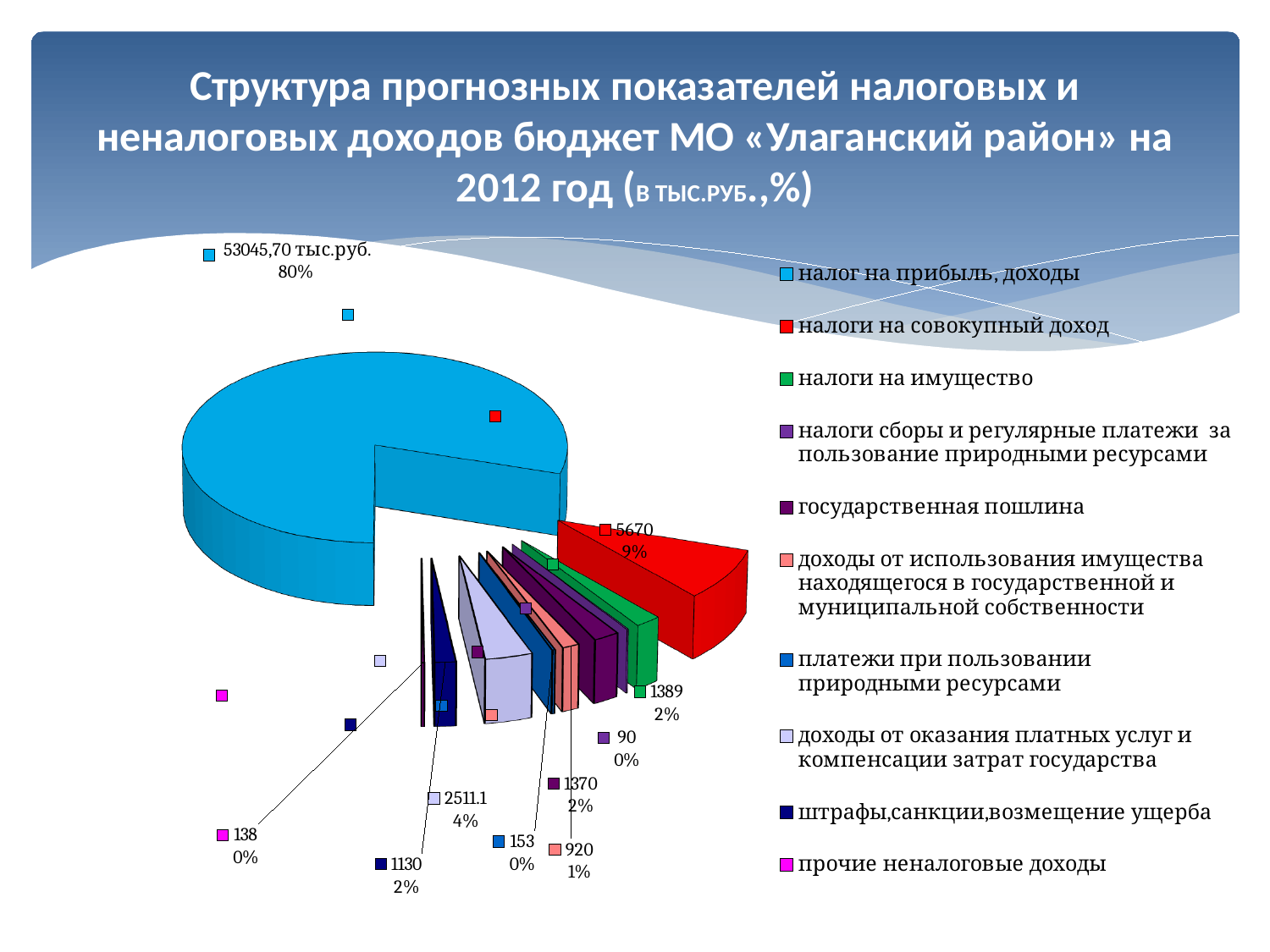
Which is larger: the value for "государственная пошлина" or the value for "доходы от использования имущества находящегося в государственной и муниципальной собственности"? государственная пошлина What value is shown for the slice "налог на прибыль, доходы"? 53045,70 тыс.руб. How many entries does the legend list? 10 What value is shown for "налоги на совокупный доход"? 5670 What share of the pie does "налог на прибыль, доходы" represent? 80% What type of chart is shown on the slide? pie chart What value is shown for "штрафы,санкции,возмещение ущерба"? 1130 What percentage is shown for "налоги на совокупный доход"? 9% What value is shown for "доходы от оказания платных услуг и компенсации затрат государства"? 2511.1 Which category has the smallest value, "налоги сборы и регулярные платежи за пользование природными ресурсами" or "платежи при пользовании природными ресурсами"? налоги сборы и регулярные платежи за пользование природными ресурсами Which category has the largest slice of the pie? налог на прибыль, доходы What is the difference between the values for "налоги на имущество" and "государственная пошлина"? 19